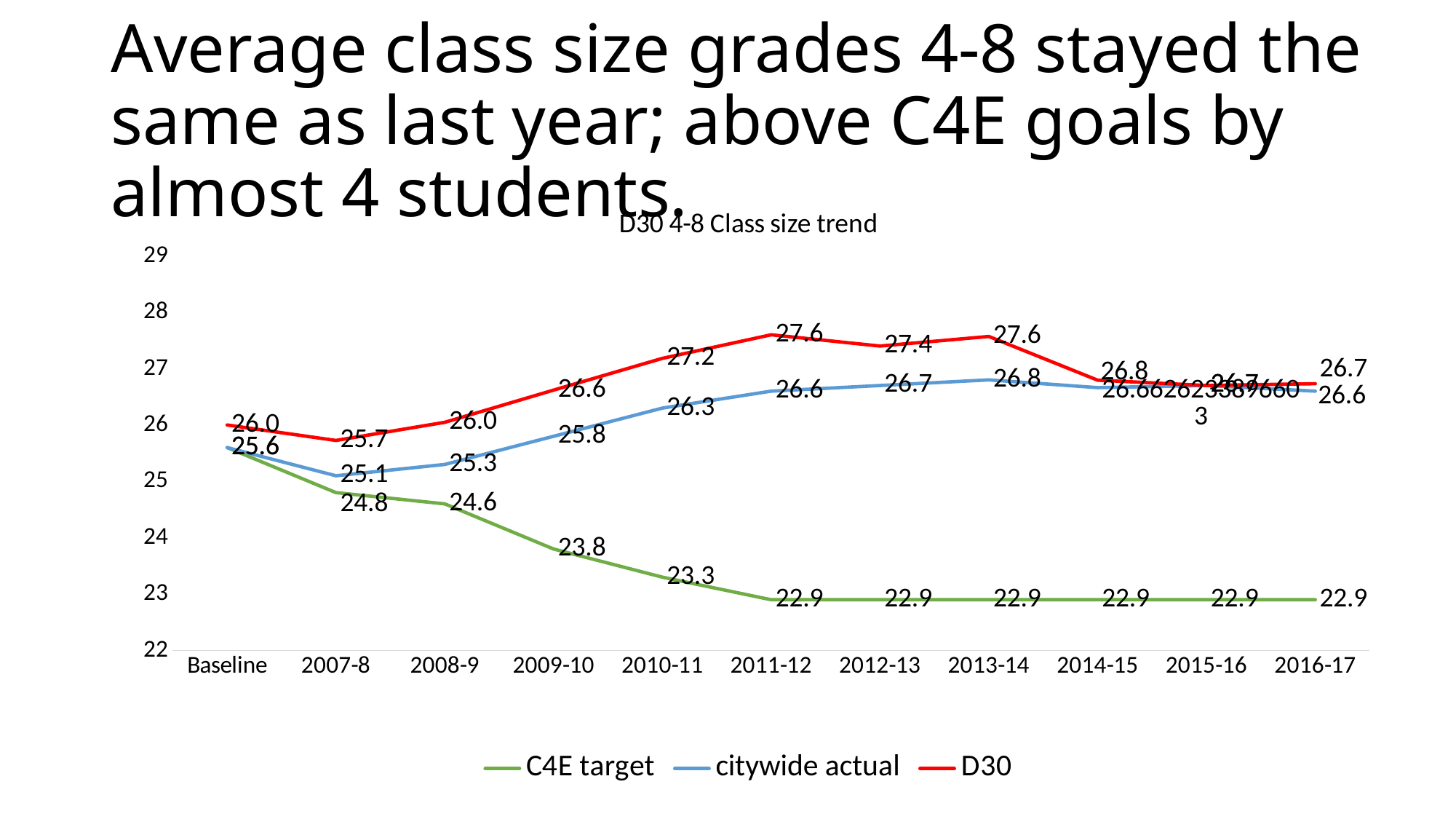
What is the C4E target value for 2010-11? 23.3 What is the difference between the D30 value and the C4E target value in 2016-17? 3.8 What is the D30 value for 2011-12? 27.6 Is the citywide actual value for 2014-15 greater or less than 27? less Which is larger in 2010-11, the D30 value or the citywide actual value? D30 How many points are plotted along the x axis for each series? 11 Does the C4E target series rise or fall from Baseline to 2011-12? fall How many series does the legend list? 3 In which year is the D30 value lowest? 2007-8 What kind of chart is shown on the slide? line chart What is the title of the chart? D30 4-8 Class size trend What is the citywide actual value for 2009-10? 25.8